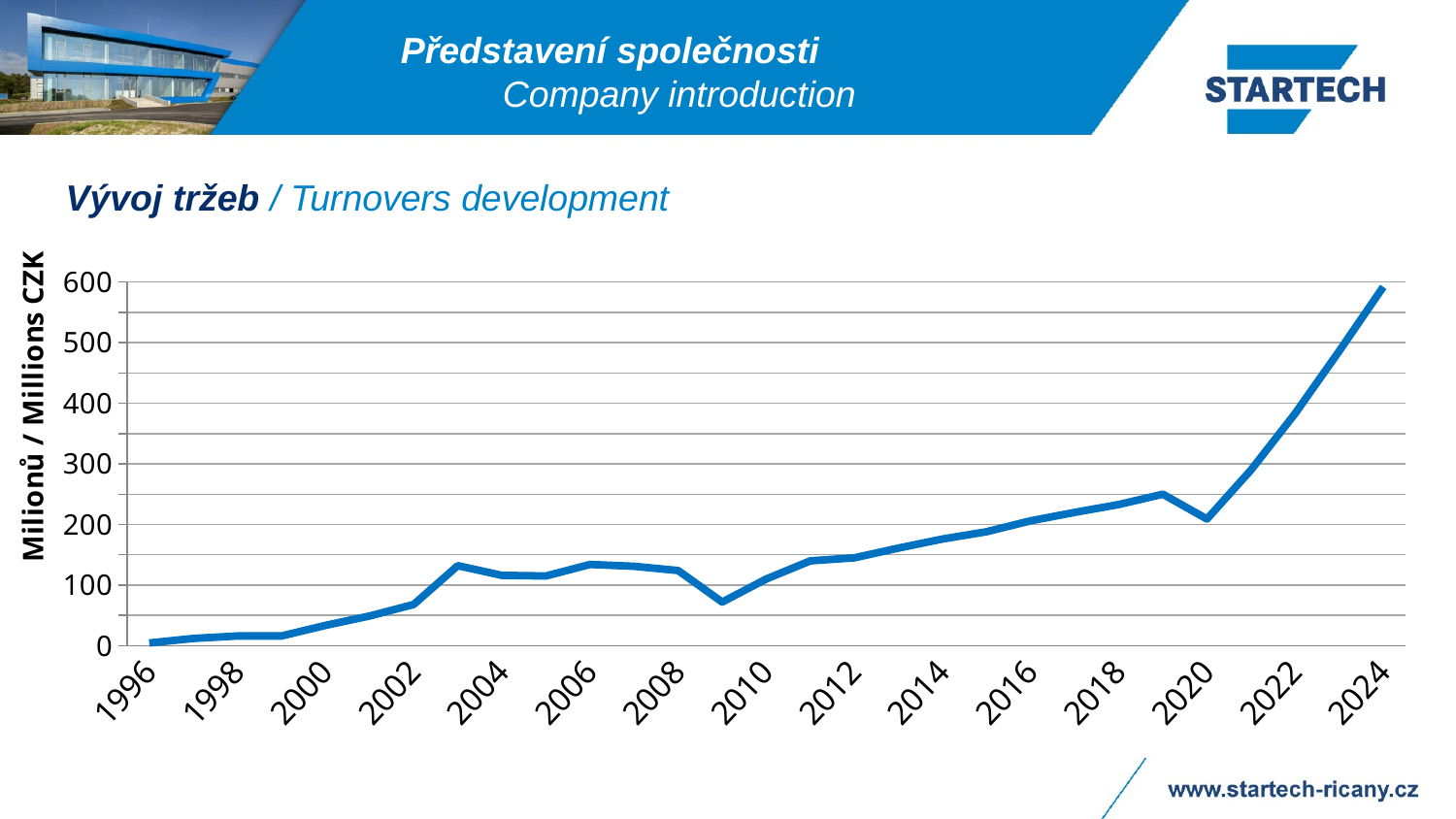
Which year has the highest turnover value on the chart? 2024 What is the label on the vertical axis of the chart? Milionů / Millions CZK Is the value for 2024 greater or less than 500? greater Is the value for 2014 greater or less than 200? less What kind of chart is shown on the slide? line chart Overall, do the values rise or fall from 1996 to 2024? rise Is the value for 2002 greater or less than 100? less Which is larger, the value for 2018 or the value for 2020? 2018 Which year has the lowest turnover value on the chart? 1996 Which is larger, the value for 2008 or the value for 2010? 2008